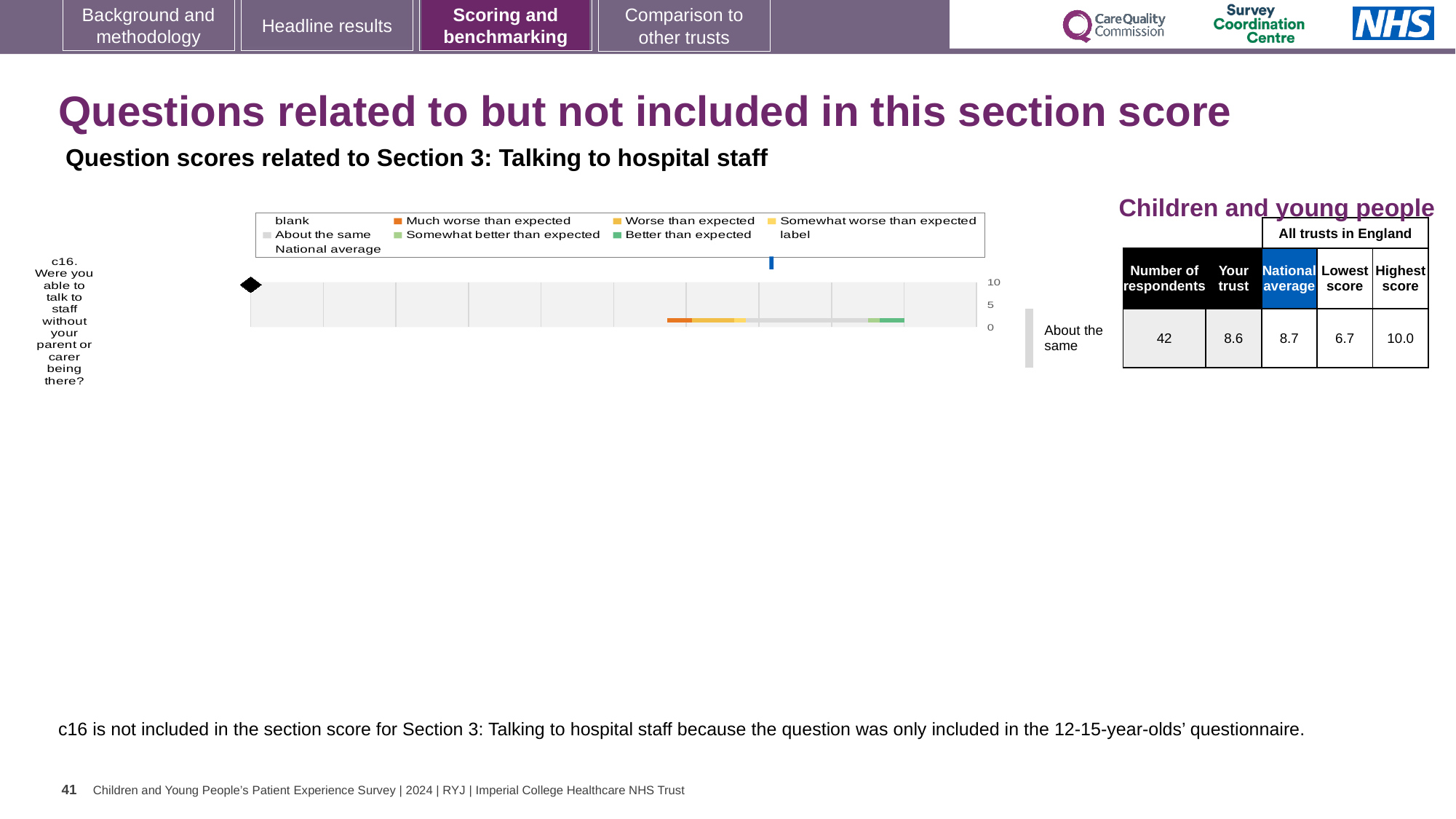
Is the 'Your trust' score for c16 larger or smaller than the national average? smaller In the table next to the chart, what is the number of respondents for c16? 42 In the table next to the chart, what is the highest score among all trusts in England for c16? 10.0 What is the highest value shown on the chart's axis? 10 How many questions (categories) are plotted in the chart? 1 What is the difference between the highest score and the lowest score for c16 in the table? 3.3 In the table next to the chart, what is the 'Your trust' score for c16? 8.6 Which question is plotted in the chart? c16. Were you able to talk to staff without your parent or carer being there? How many entries does the chart legend list? 9 In the table next to the chart, what is the lowest score among all trusts in England for c16? 6.7 In the table next to the chart, what is the national average score for c16? 8.7 What kind of chart is shown for question c16? bar chart